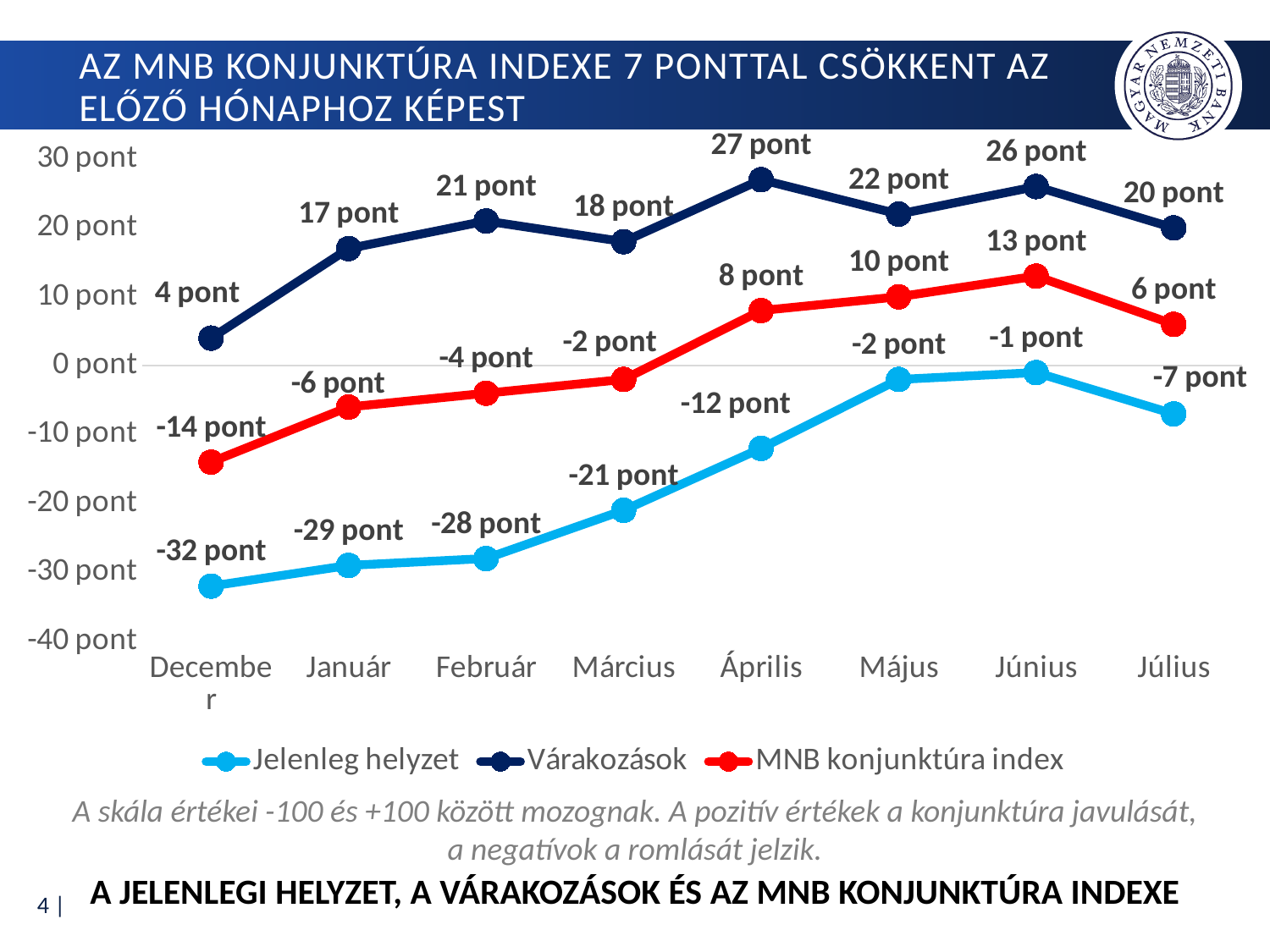
What is the value of the MNB konjunktúra index in Július? 6 pont Does the Jelenleg helyzet series generally rise or fall from December to Június? rise What is the value of Várakozások in Április? 27 pont In which month is the Várakozások series at its highest? Április Which series is drawn in red? MNB konjunktúra index What type of chart is shown on the slide? line chart How many months are plotted along the x axis? 8 Which is larger in Május: the Várakozások value or the MNB konjunktúra index value? Várakozások In which month is the Jelenleg helyzet series at its lowest? December How many series does the legend list? 3 What is the value of Jelenleg helyzet in December? -32 pont What is the difference between the MNB konjunktúra index in Június and in Július? 7 pont